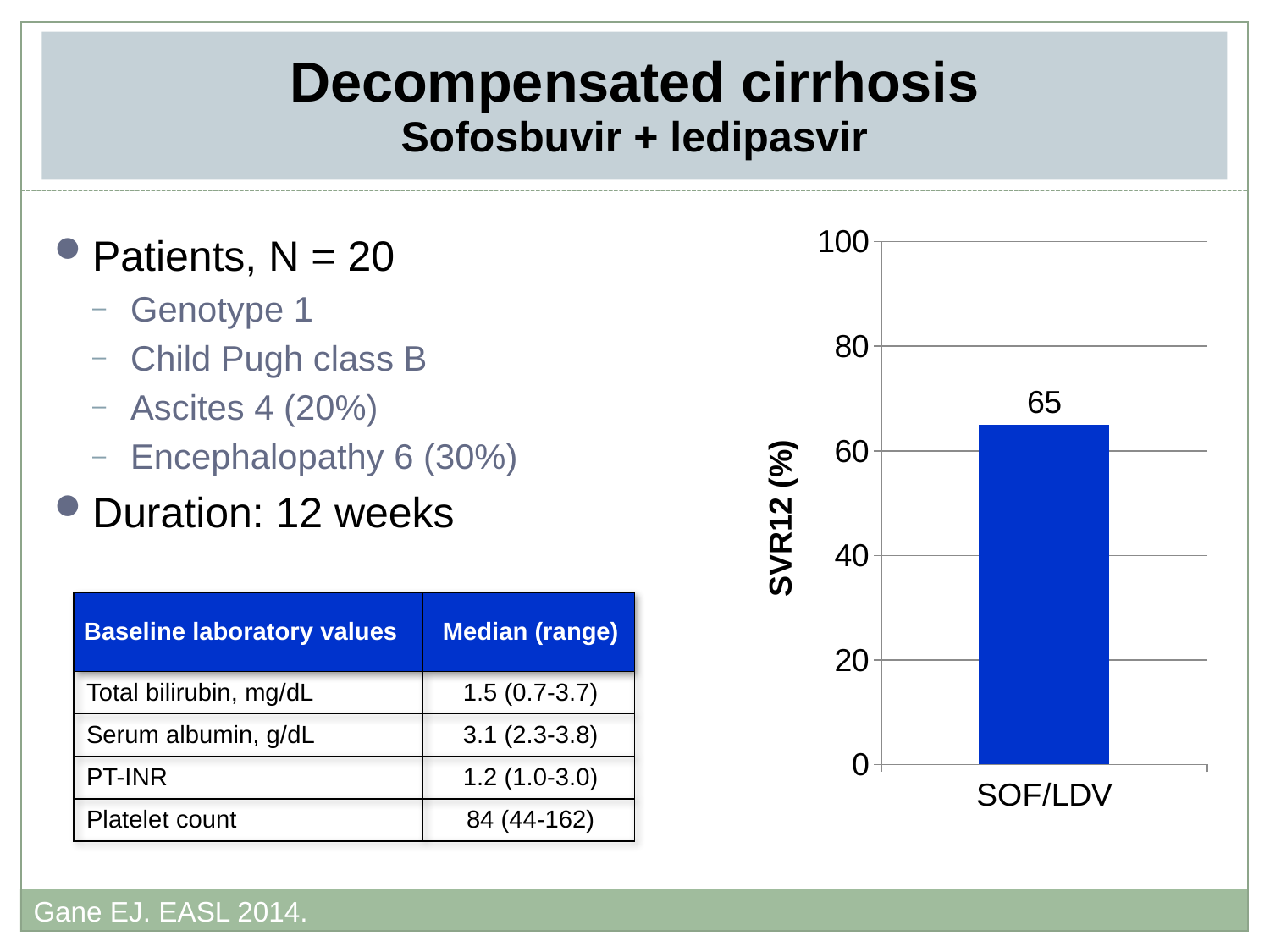
What is the label of the y axis in the chart? SVR12 (%) How far below 100 is the SVR12 value for SOF/LDV? 35 What is the maximum value shown on the y axis of the chart? 100 What is the category label shown on the x axis of the chart? SOF/LDV Is the value for SOF/LDV greater or less than 60? greater How many bars are plotted in the chart? 1 What kind of chart is shown on the slide? bar chart Is the value for SOF/LDV greater or less than 80? less What is the SVR12 value for SOF/LDV in the chart? 65